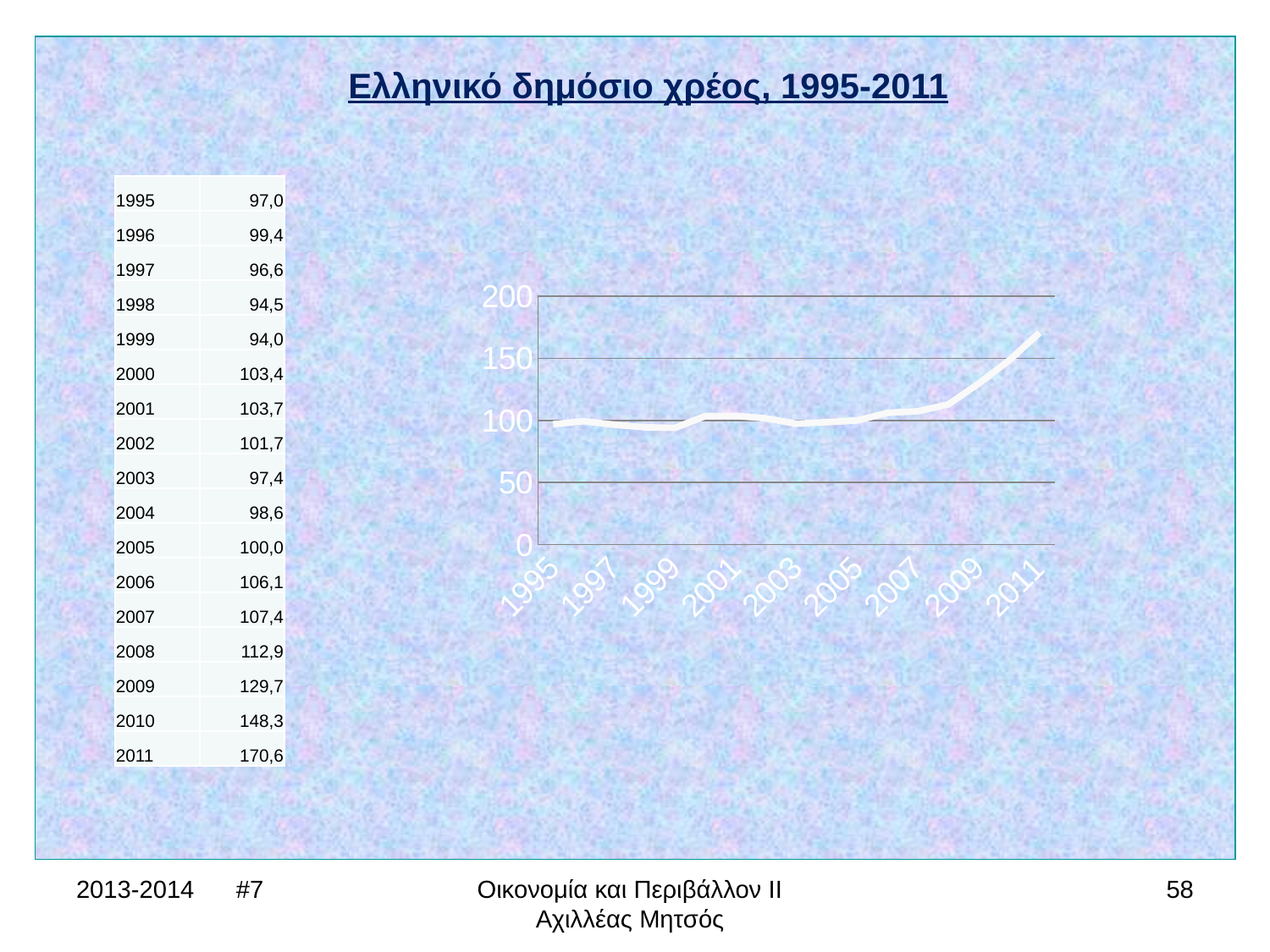
Which is larger, the value for 2009 or the value for 2008? 2009 What kind of chart is shown on the slide? line chart Which year has the lowest value? 1999 What is the value for 2005? 100,0 Which year has the highest value? 2011 Is the value for 2011 greater or less than 150? greater What is the difference between the values for 2011 and 2010? 22,3 Is the value for 2003 greater or less than 150? less Do the values rise or fall between 2008 and 2011? rise How many years are plotted on the chart? 17 What is the value for 2011? 170,6 What is the value for 1995? 97,0